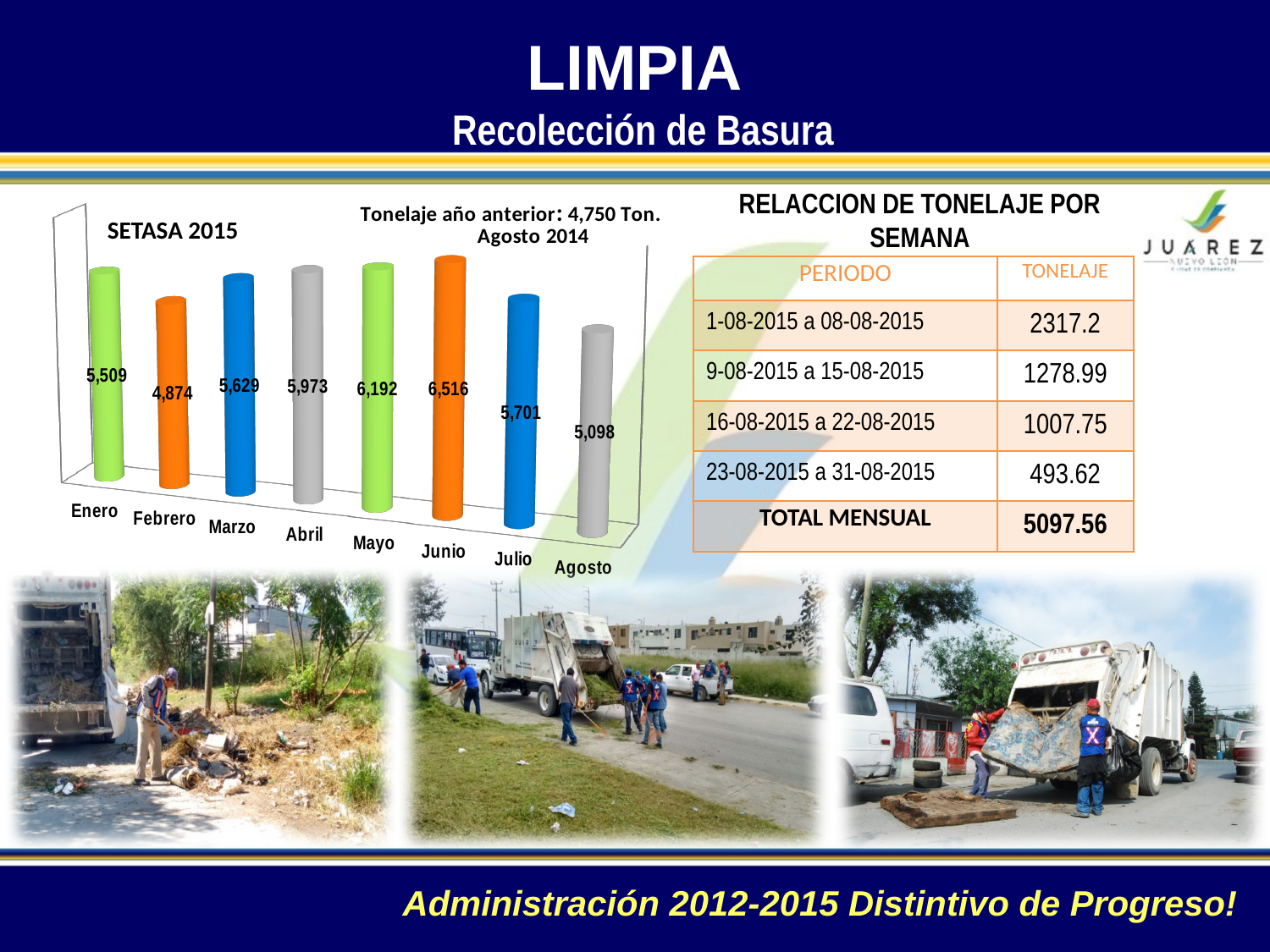
What is the value for Febrero in the SETASA 2015 chart? 4,874 What is the difference between the values for Mayo and Abril in the SETASA 2015 chart? 219 Which month has the lowest value in the SETASA 2015 chart? Febrero What is the difference between the values for Junio and Febrero in the SETASA 2015 chart? 1,642 Do the values in the SETASA 2015 chart rise or fall from Febrero to Junio? Rise Which month has the highest value in the SETASA 2015 chart? Junio Which is larger in the SETASA 2015 chart, the value for Marzo or the value for Julio? Julio What is the value for Agosto in the SETASA 2015 chart? 5,098 What kind of chart is the SETASA 2015 chart? Bar chart What tonnage for the previous year (Agosto 2014) is noted above the SETASA 2015 chart? 4,750 Ton. How many months are plotted in the SETASA 2015 chart? 8 What is the value for Junio in the SETASA 2015 chart? 6,516